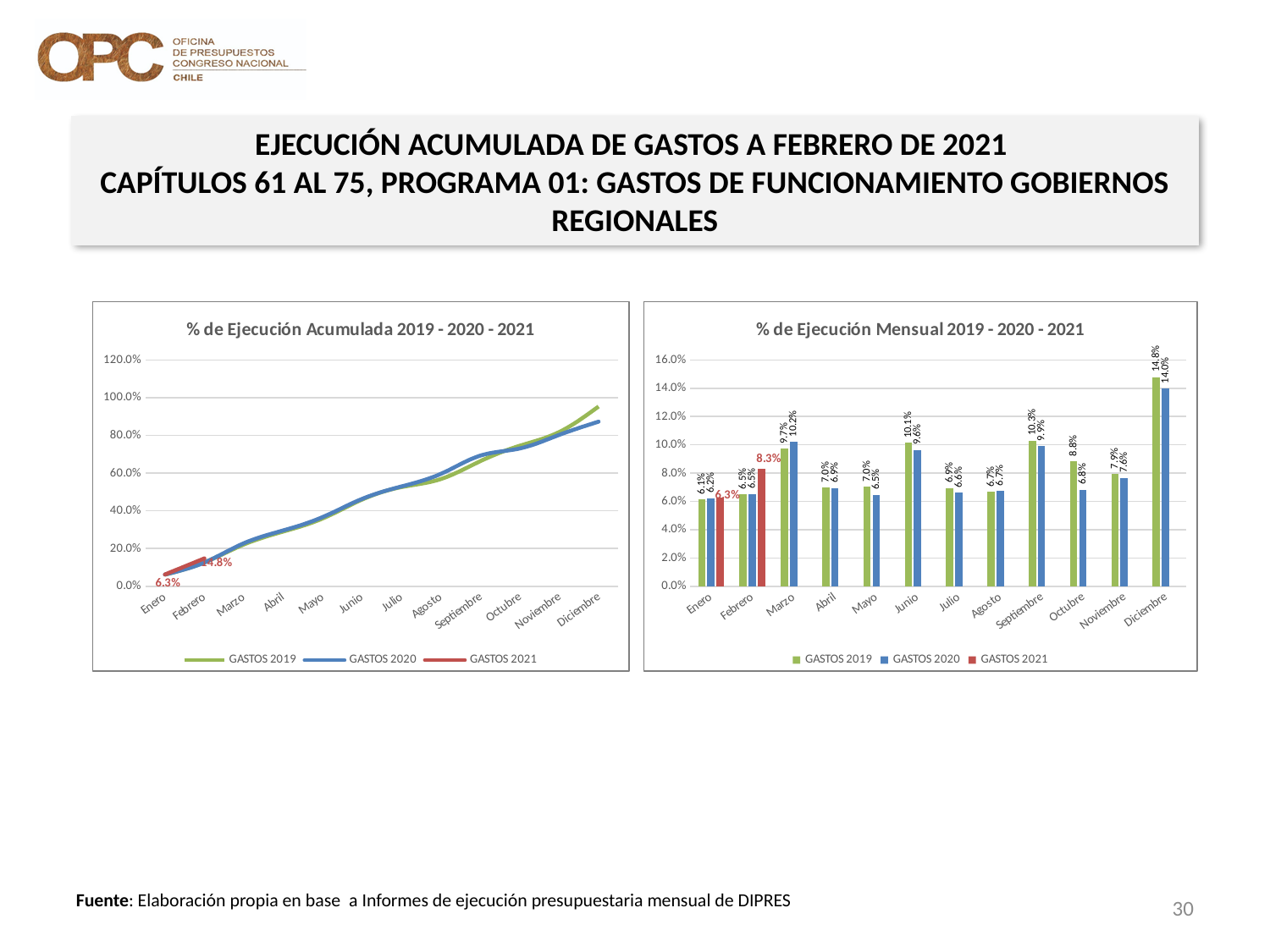
In the '% de Ejecución Mensual 2019 - 2020 - 2021' chart, which month has the highest value for GASTOS 2019? Diciembre What kind of chart is the left-hand chart, '% de Ejecución Acumulada 2019 - 2020 - 2021'? Line chart In the '% de Ejecución Acumulada 2019 - 2020 - 2021' chart, do the GASTOS 2019 and GASTOS 2020 lines rise or fall from Enero to Diciembre? Rise In the '% de Ejecución Mensual 2019 - 2020 - 2021' chart, how many series does the legend list? 3 In the '% de Ejecución Mensual 2019 - 2020 - 2021' chart, what is the value for GASTOS 2021 in Febrero? 8.3% In the '% de Ejecución Acumulada 2019 - 2020 - 2021' chart, is the value for GASTOS 2020 in Diciembre greater or less than 80.0%? greater In the '% de Ejecución Mensual 2019 - 2020 - 2021' chart, which is larger in Octubre, GASTOS 2019 or GASTOS 2020? GASTOS 2019 In the '% de Ejecución Mensual 2019 - 2020 - 2021' chart, what is the difference between GASTOS 2019 and GASTOS 2020 in Diciembre? 0.8% In the '% de Ejecución Mensual 2019 - 2020 - 2021' chart, what is the value for GASTOS 2020 in Junio? 9.6% In the '% de Ejecución Acumulada 2019 - 2020 - 2021' chart, what is the value for GASTOS 2021 in Febrero? 14.8% What kind of chart is the right-hand chart, '% de Ejecución Mensual 2019 - 2020 - 2021'? Bar chart How many months are shown on the x axis of the '% de Ejecución Mensual 2019 - 2020 - 2021' chart? 12